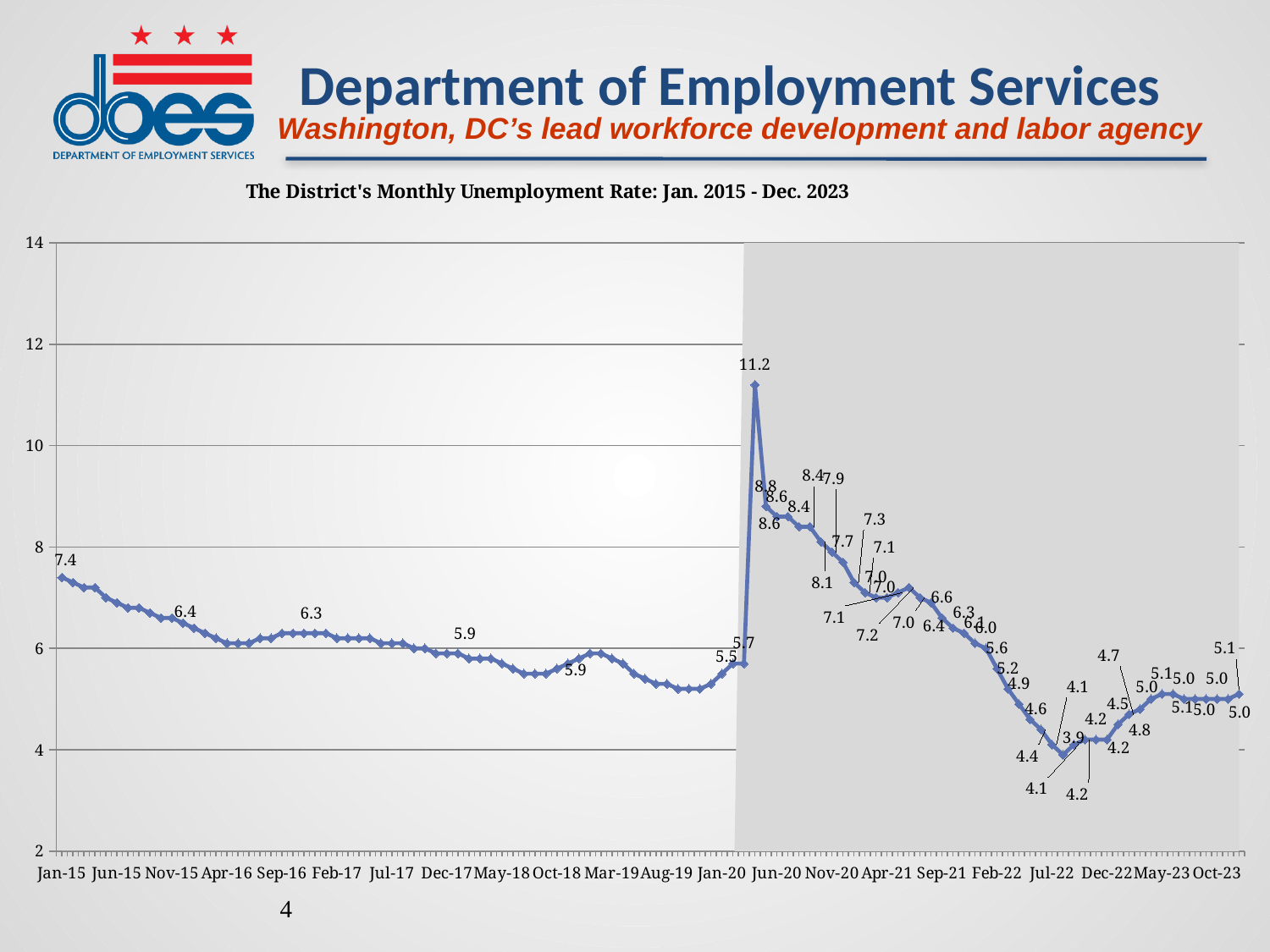
What kind of chart is shown on the slide? line chart What is the unemployment rate for Jan-15? 7.4 What is the unemployment rate at the last point on the chart (Dec-23)? 5.1 Does the unemployment rate rise or fall from its peak in 2020 through mid-2022? fall What is the difference between the highest value (11.2) and the lowest value (3.9) on the chart? 7.3 Is the value for Jul-22 greater or less than 6? less Is the value for Jan-20 greater or less than 6? less What is the highest unemployment rate shown on the chart? 11.2 What is the lowest unemployment rate shown on the chart? 3.9 Which is larger, the unemployment rate at Jan-15 or at Dec-23? Jan-15 What is the difference between the Jan-15 value and the peak value of 11.2? 3.8 What is the title of the chart? The District's Monthly Unemployment Rate: Jan. 2015 - Dec. 2023